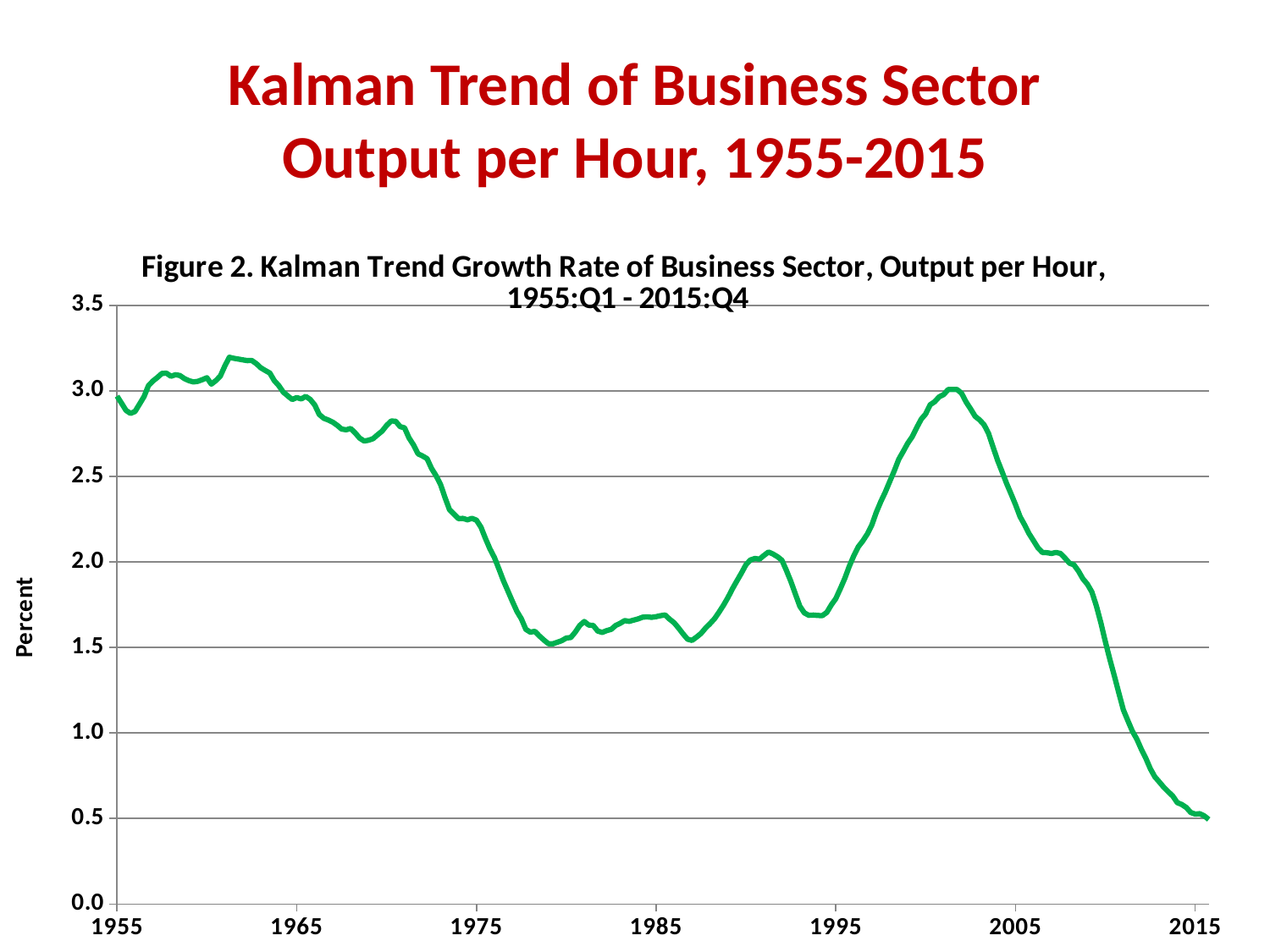
Is the value for 2015 greater or less than 1.0? less Is the value for 1995 greater or less than 2.0? less Does the line rise or fall between 2005 and 2015? fall How many year labels are shown along the horizontal axis? 7 What is the title printed above the chart area? Figure 2. Kalman Trend Growth Rate of Business Sector, Output per Hour, 1955:Q1 - 2015:Q4 What kind of chart is shown on the slide? line chart Is the value for 2005 greater or less than 2.0? greater What is the label on the vertical axis of the chart? Percent Which year has the larger value, 1955 or 2015? 1955 Which year has the larger value, 1965 or 1985? 1965